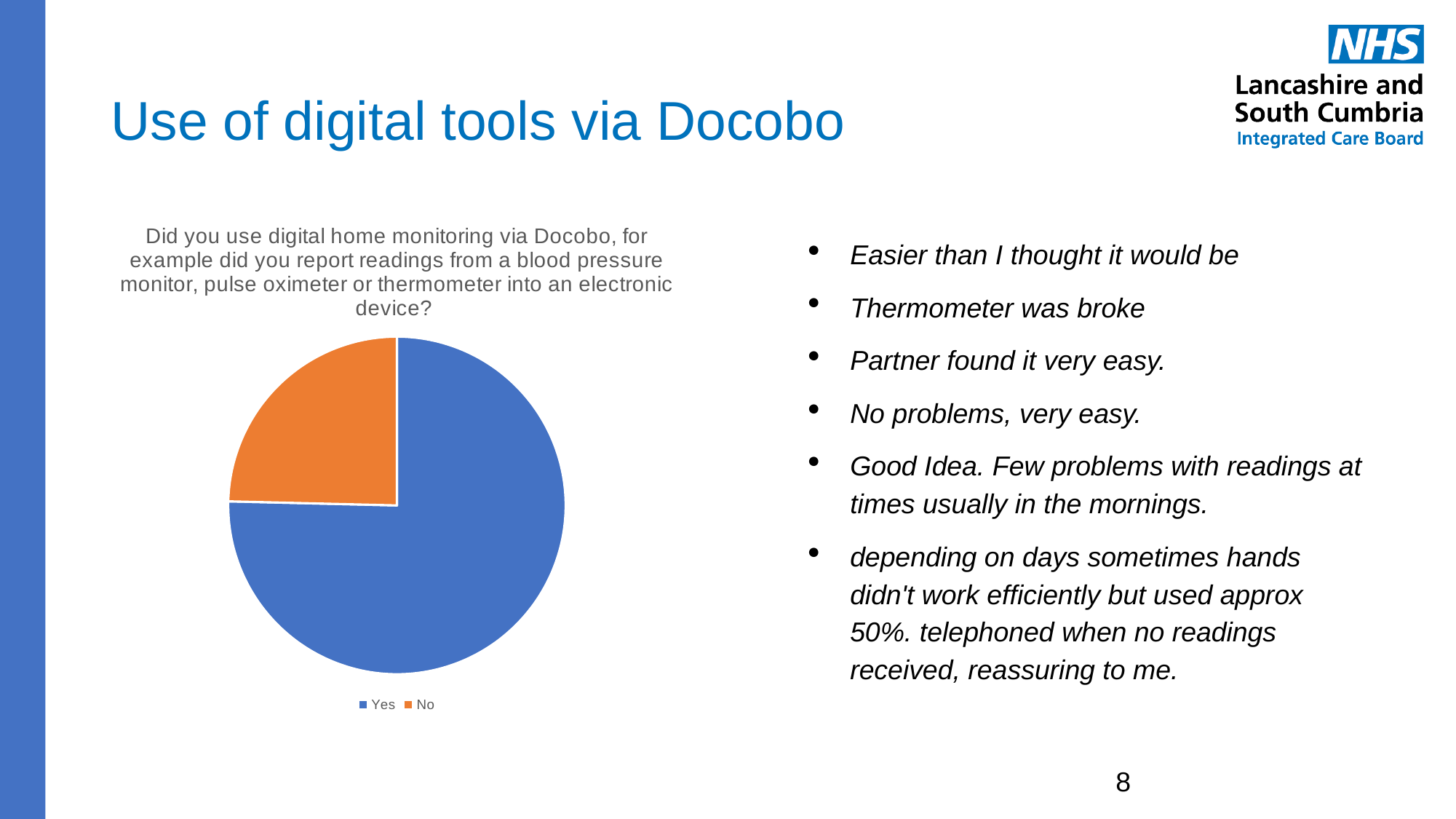
How many entries does the legend of the pie chart list? 2 Which slice of the pie chart is the smallest? No Which is larger in the pie chart, the Yes slice or the No slice? Yes How many slices does the pie chart have? 2 What colour is the Yes slice in the pie chart? blue What colour is the No slice in the pie chart? orange Which slice of the pie chart is the largest? Yes What kind of chart is shown on the slide? pie chart